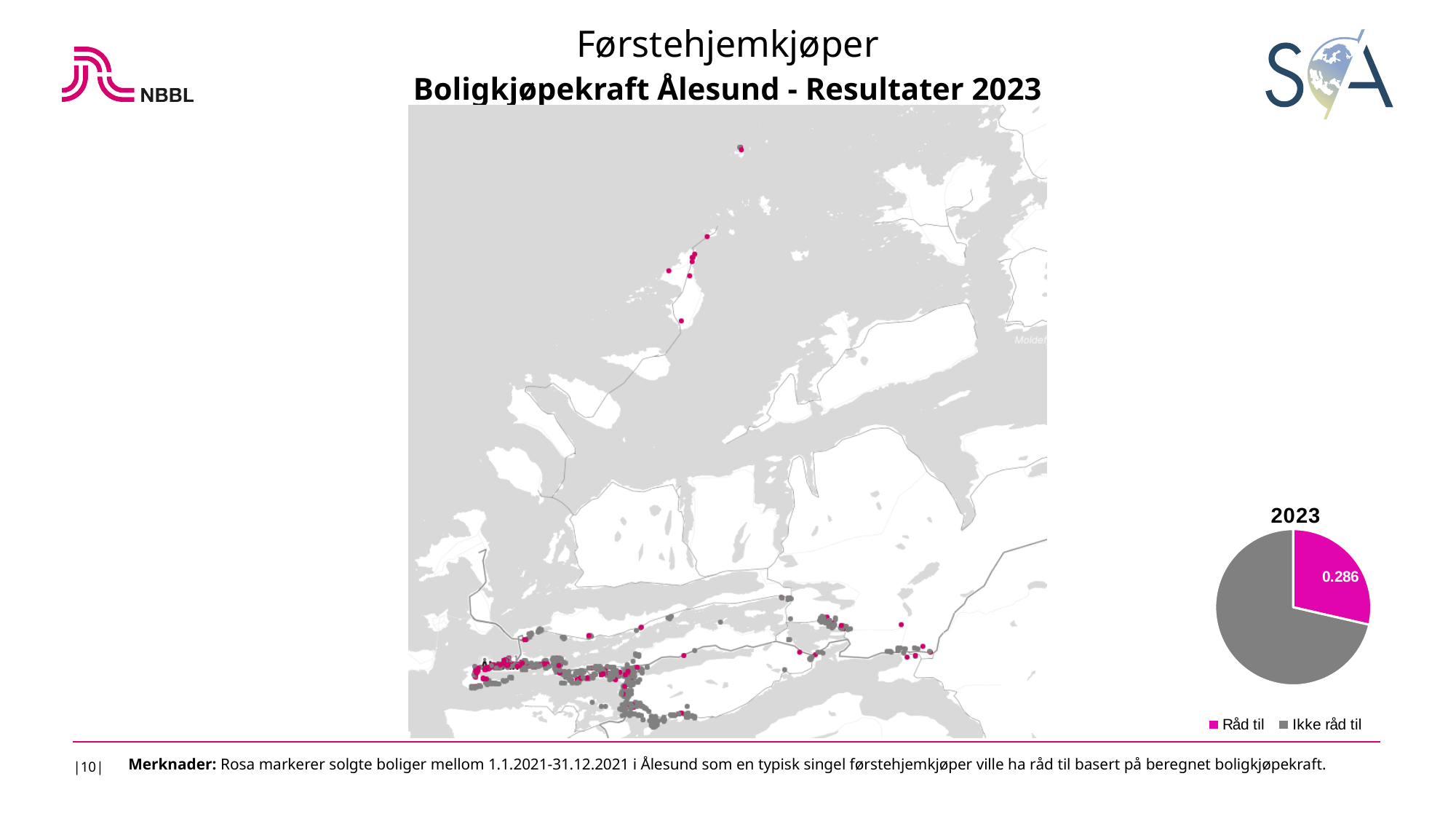
What share of the pie does the 'Råd til' slice represent? 0.286 Which slice of the pie chart is the largest? Ikke råd til Which colour represents 'Ikke råd til' in the pie chart? Grey In the pie chart, what value is printed on the 'Råd til' slice? 0.286 In the pie chart, which is larger: 'Råd til' or 'Ikke råd til'? Ikke råd til Which slice of the pie chart is the smallest? Råd til How many slices does the pie chart have? 2 Is the 'Råd til' slice of the pie chart greater or less than half of the pie? less What is the title of the pie chart? 2023 How many entries does the pie chart's legend list? 2 What kind of chart is shown at the bottom right of the slide? Pie chart